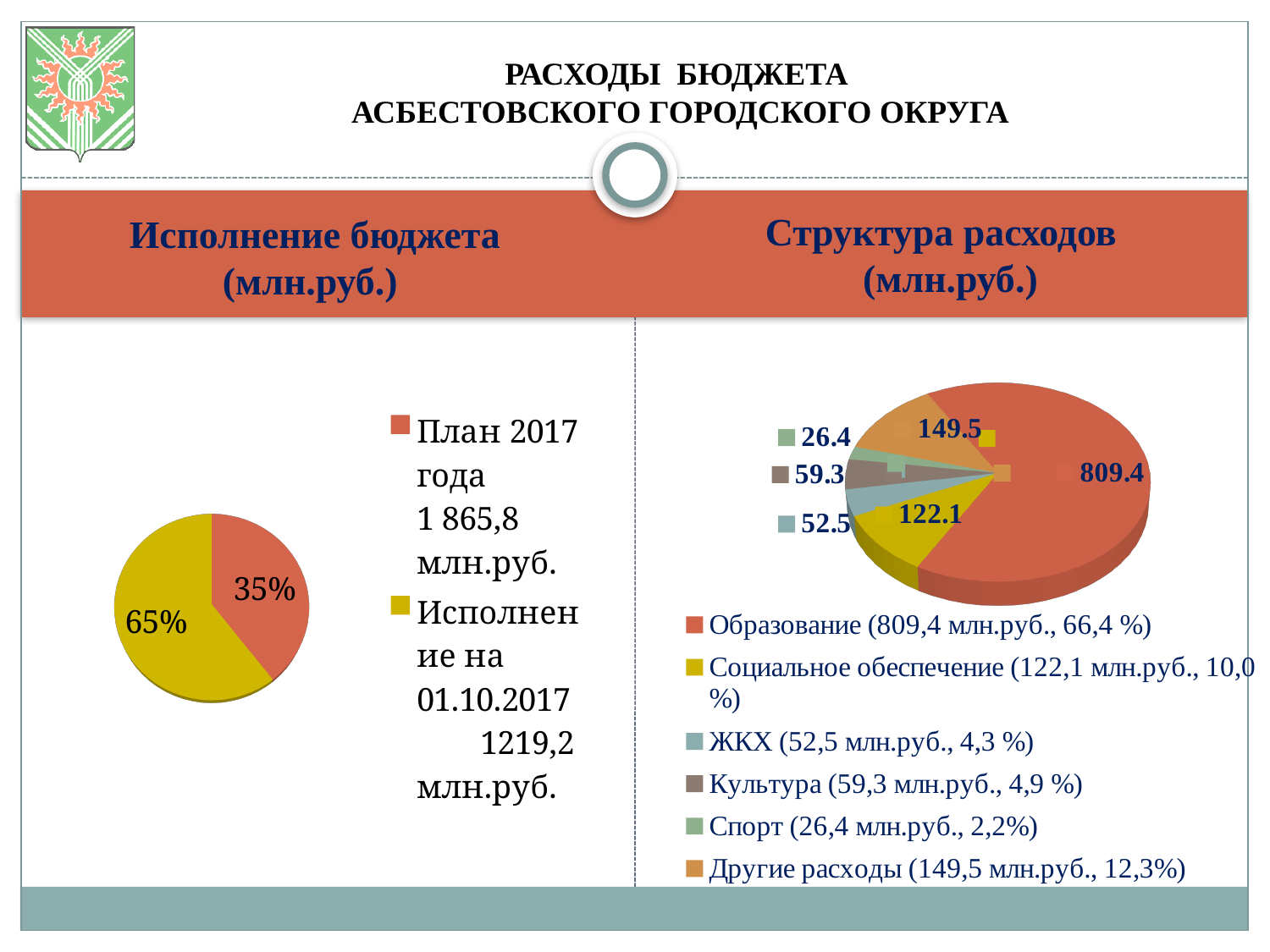
In the "Структура расходов" pie chart, which is larger: Культура or ЖКХ? Культура In the "Структура расходов" pie chart, what value is labelled on the Социальное обеспечение slice? 122.1 In the "Структура расходов" pie chart, which category has the smallest slice? Спорт What kind of chart is shown under "Структура расходов (млн.руб.)"? pie chart In the "Структура расходов" pie chart, what is the difference between the Другие расходы value (149.5) and the Социальное обеспечение value (122.1)? 27.4 In the "Исполнение бюджета (млн.руб.)" pie chart, what percentage is labelled on the yellow slice? 65% In the "Структура расходов" pie chart, which category has the largest slice? Образование In the "Структура расходов" pie chart, what value is labelled on the Образование slice? 809.4 How many slices does the "Исполнение бюджета (млн.руб.)" pie chart have? 2 How many slices does the "Структура расходов" pie chart have? 6 According to the legend of the "Структура расходов" chart, what share of expenses is Другие расходы? 12,3% According to the legend of the "Структура расходов" chart, what share of expenses is Образование? 66,4 %